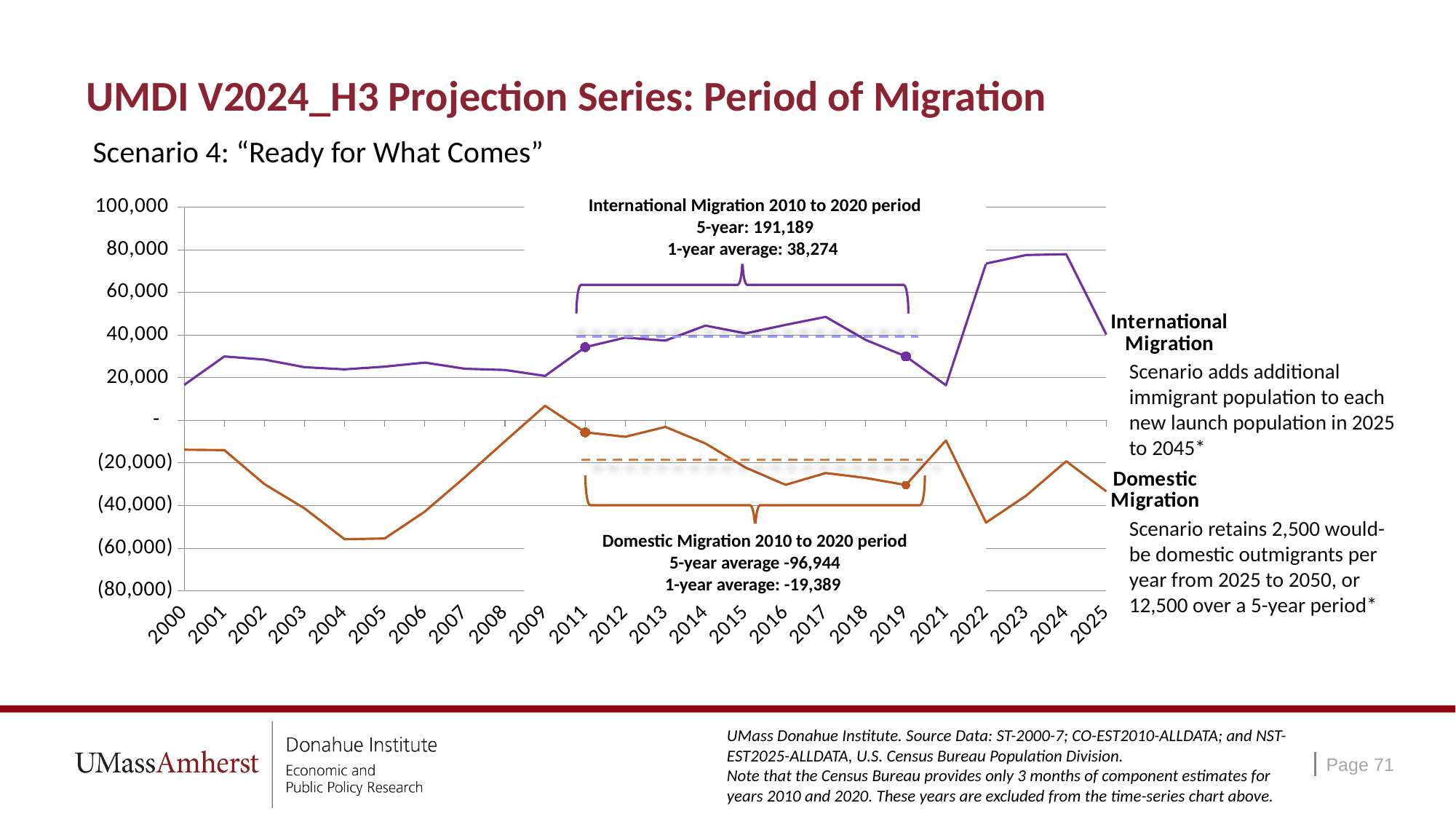
What is the 5-year average Domestic Migration for the 2010 to 2020 period given on the chart? -96,944 Does International Migration rise or fall from 2021 to 2024? rise What is the 1-year average International Migration for the 2010 to 2020 period given on the chart? 38,274 Is the International Migration value for 2024 greater or less than 60,000? greater Which is larger, International Migration in 2022 or International Migration in 2000? 2022 What kind of chart is shown on the slide? line chart How many series are plotted on the chart? 2 In which year is Domestic Migration at its highest? 2009 What is the 5-year International Migration figure for the 2010 to 2020 period given on the chart? 191,189 Is the International Migration value for 2000 greater or less than 20,000? less How many years are shown on the x axis of the chart? 24 What is the 1-year average Domestic Migration for the 2010 to 2020 period given on the chart? -19,389